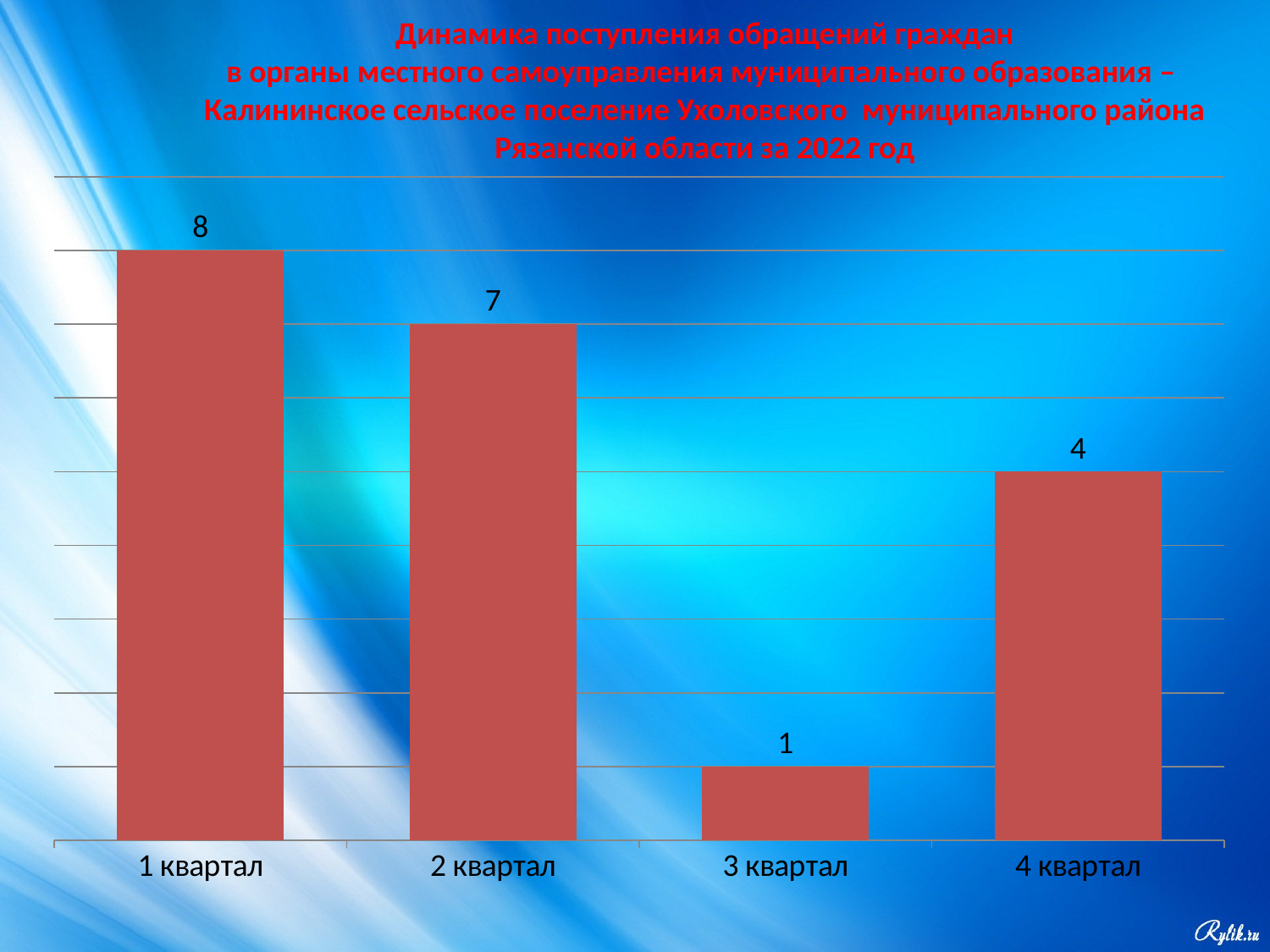
What kind of chart is shown on the slide? Bar chart What is the value for 4 квартал? 4 How many categories are shown on the x axis? 4 Which quarter has the highest value? 1 квартал What is the value for 3 квартал? 1 What is the total of the values across all four quarters? 20 What is the difference between the values for 1 квартал and 4 квартал? 4 What is the value for 2 квартал? 7 What is the difference between the values for 2 квартал and 3 квартал? 6 Which is larger, the value for 2 квартал or the value for 4 квартал? 2 квартал What is the value for 1 квартал? 8 Which quarter has the lowest value? 3 квартал